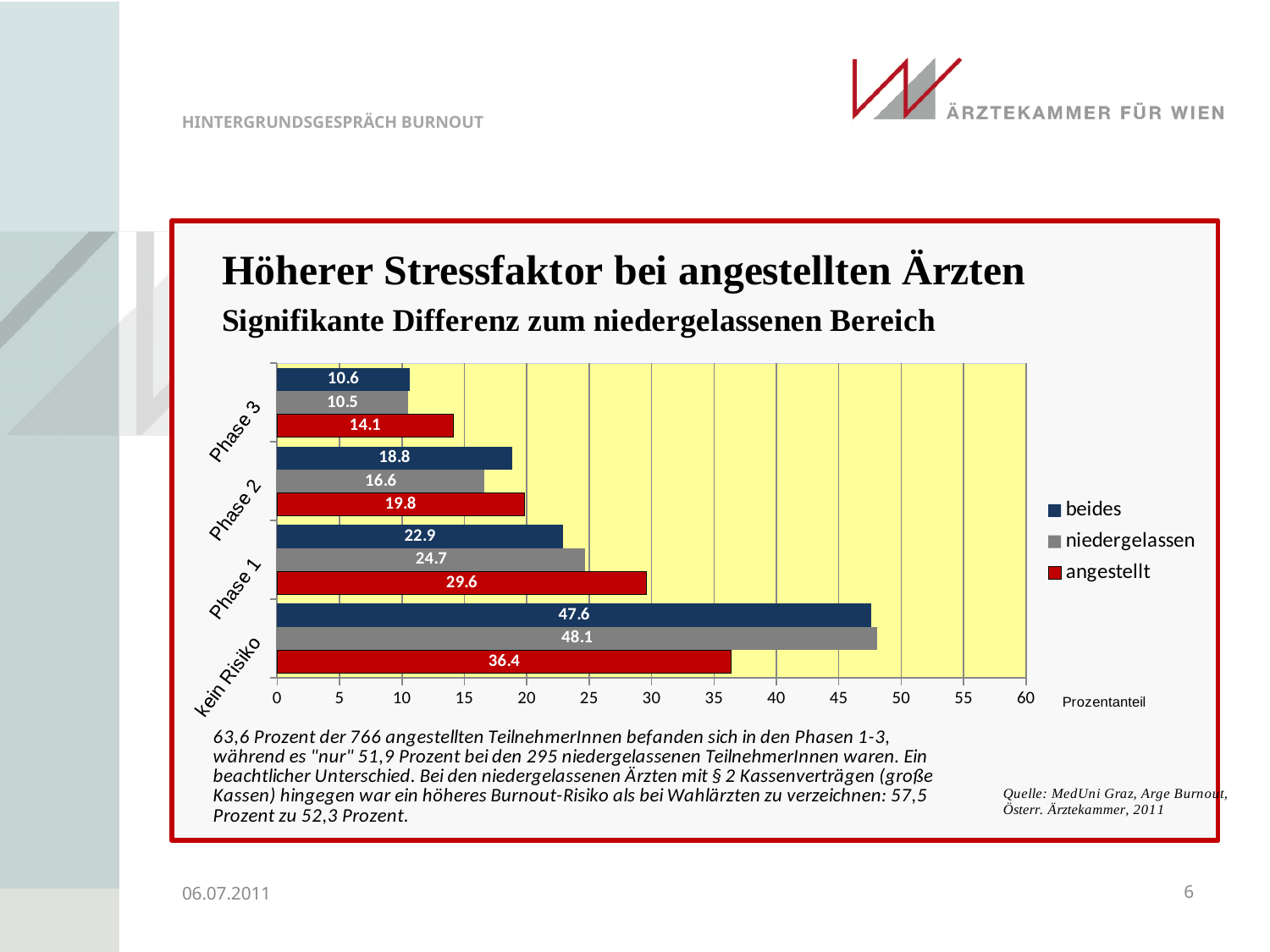
What is the value for 'angestellt' in Phase 1? 29.6 How many categories are shown on the vertical axis? 4 What kind of chart is shown on the slide? bar chart Which category has the highest value for the 'angestellt' series? kein Risiko What is the value for 'beides' in Phase 2? 18.8 How many series does the legend list? 3 What is the value for 'niedergelassen' in the 'kein Risiko' category? 48.1 What is the difference between 'angestellt' and 'niedergelassen' in the 'kein Risiko' category? 11.7 Is the value for 'beides' in the 'kein Risiko' category greater or less than 45? greater What label is shown for the horizontal axis? Prozentanteil Which category has the lowest value for the 'niedergelassen' series? Phase 3 In Phase 1, which is larger: 'angestellt' or 'beides'? angestellt